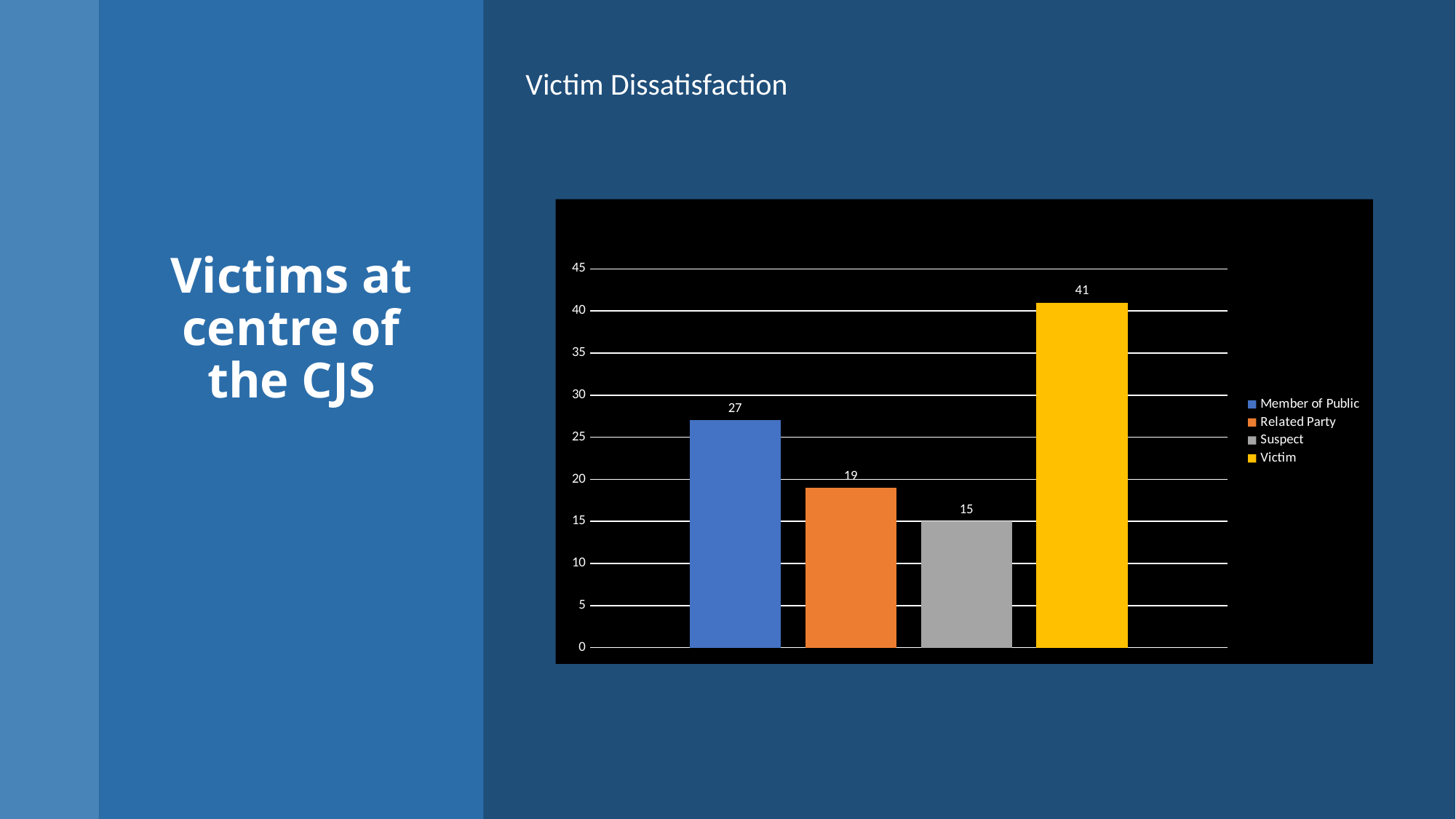
Which series has the highest value? Victim What is the difference between the values for Victim and Member of Public? 14 Which series has the lowest value? Suspect What is the title of the chart? Victim Dissatisfaction What is the value for Member of Public? 27 What is the difference between the values for Related Party and Suspect? 4 What kind of chart is shown on the slide? Bar chart Which is larger, the value for Member of Public or the value for Related Party? Member of Public What is the value for Suspect? 15 What is the value for Related Party? 19 How many series does the legend list? 4 What is the value for Victim? 41